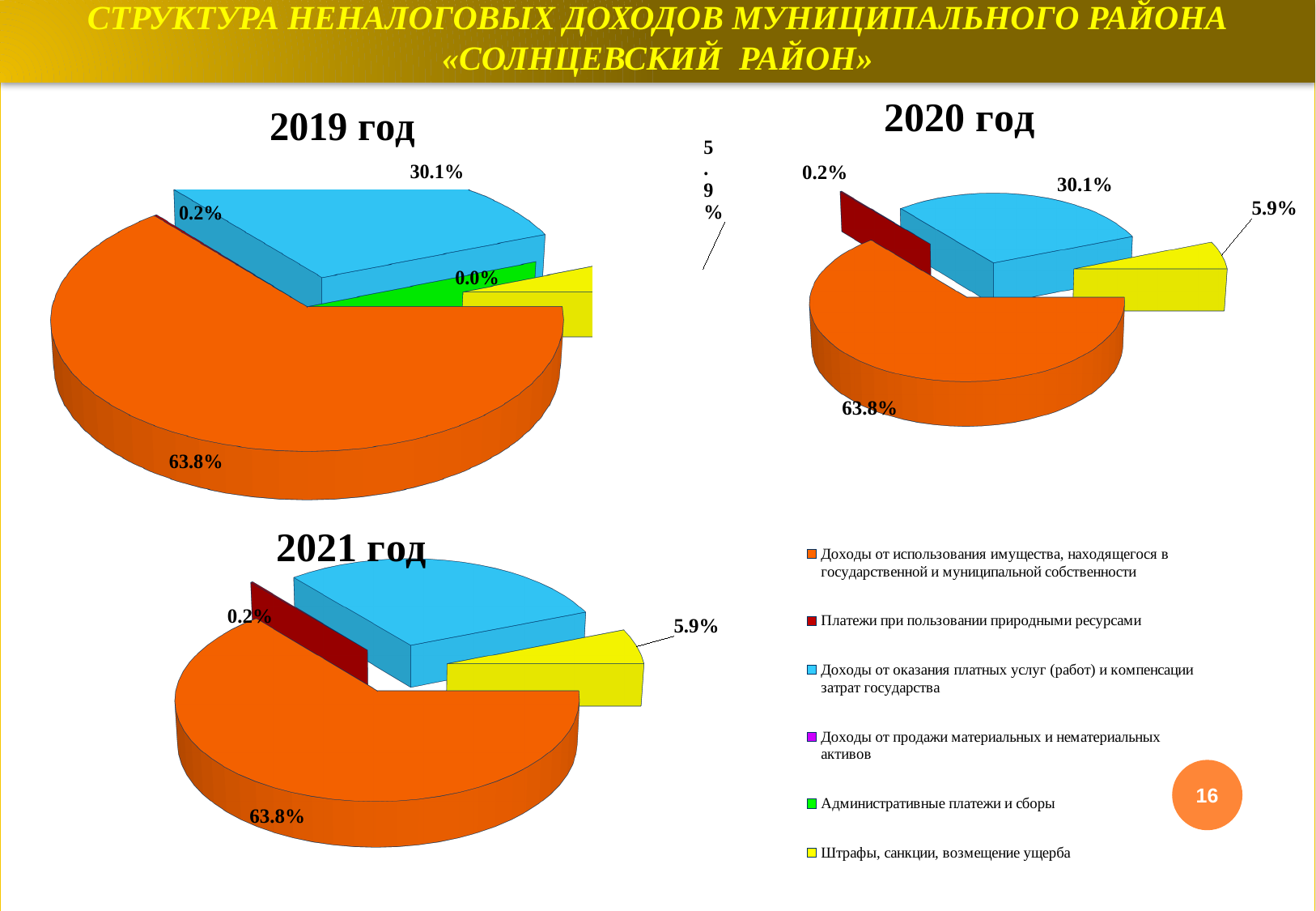
How many categories does the shared legend list? 6 In the 2021 год chart, which labelled category has the smallest share? Платежи при пользовании природными ресурсами (0.2%) How many pie charts are shown on the slide? 3 What type of chart is used for the 2020 год data? Pie chart In the 2021 год chart, what is the difference in percentage points between the blue slice (30.1%) and the yellow slice (5.9%)? 24.2 percentage points In the 2021 год chart, which is larger: the share for Доходы от оказания платных услуг (blue) or the share for Штрафы, санкции, возмещение ущерба (yellow)? Доходы от оказания платных услуг (blue) In the 2019 год chart, what share is shown for Доходы от использования имущества, находящегося в государственной и муниципальной собственности (the orange slice)? 63.8% In the 2020 год chart, what share is shown for Штрафы, санкции, возмещение ущерба (the yellow slice)? 5.9% In the 2021 год chart, what share is shown for Доходы от оказания платных услуг (работ) и компенсации затрат государства (the blue slice)? 30.1% In the 2020 год chart, what is the difference in percentage points between the orange slice (63.8%) and the blue slice (30.1%)? 33.7 percentage points In the 2019 год chart, which category has the largest share? Доходы от использования имущества, находящегося в государственной и муниципальной собственности In the 2019 год chart, what share is shown for Административные платежи и сборы (the green slice)? 0.0%